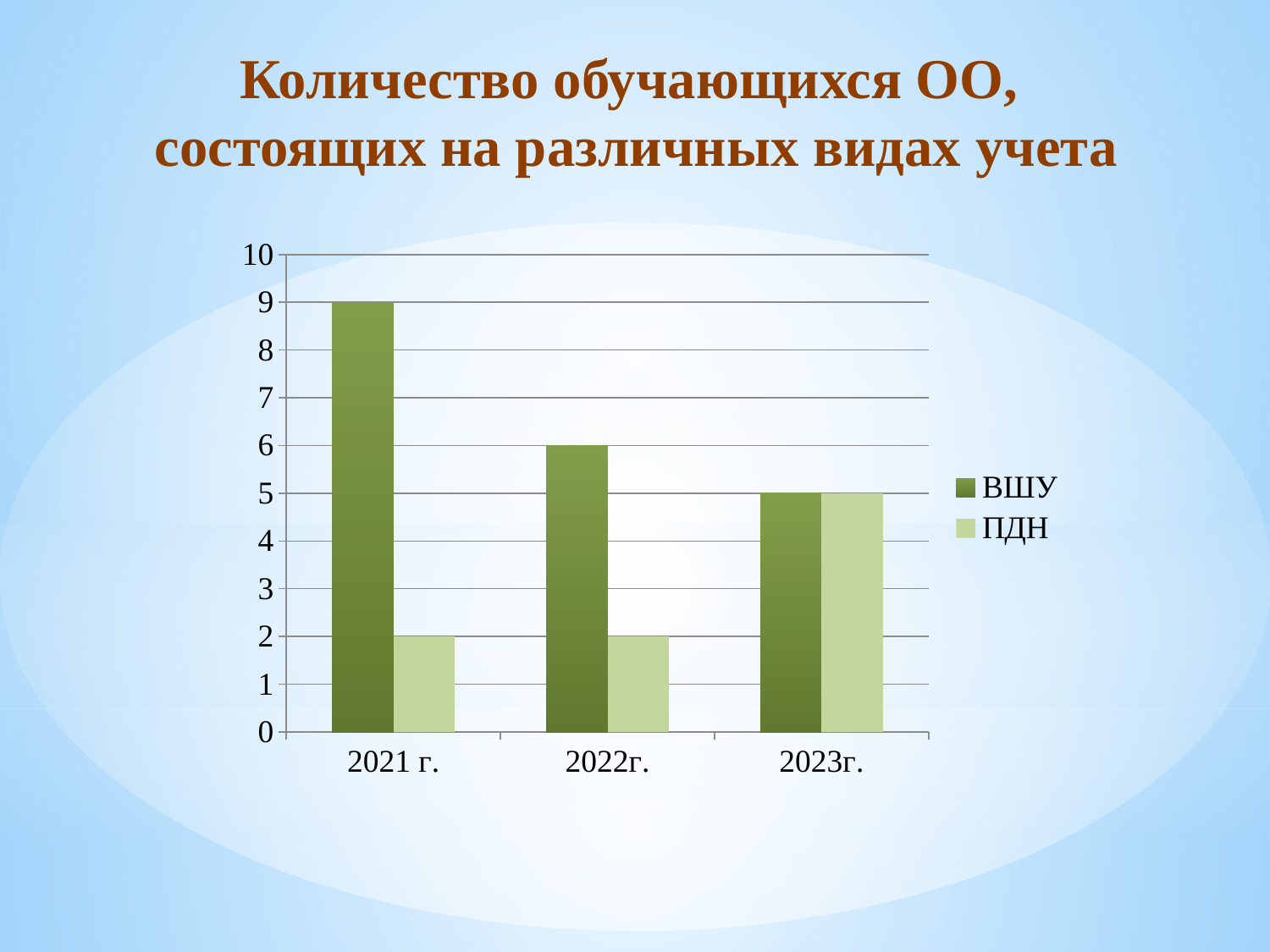
Which is larger in 2022г., ВШУ or ПДН? ВШУ In which year is the ВШУ value lowest? 2023г. In which year is the ВШУ value highest? 2021 г. How many years are shown on the x axis? 3 Do the ВШУ values rise or fall from 2021 г. to 2023г.? fall What is the difference between the ВШУ and ПДН values in 2021 г.? 7 What is the value for ВШУ in 2021 г.? 9 What is the value for ПДН in 2022г.? 2 What is the value for ВШУ in 2023г.? 5 What kind of chart is shown on the slide? bar chart How many series does the legend list? 2 Which series is shown in the darker green colour? ВШУ